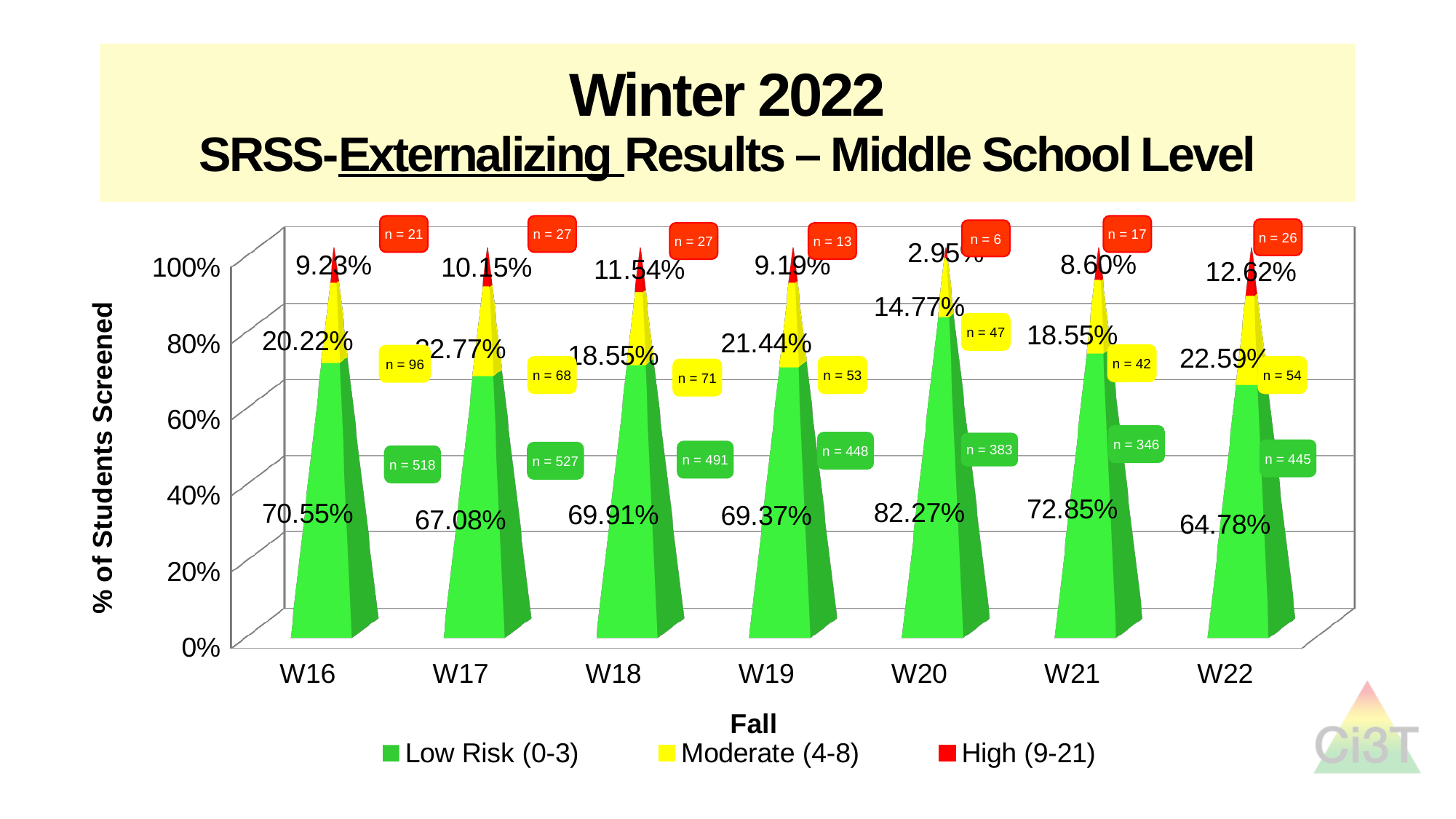
What is the Moderate (4-8) percentage for W19? 21.44% Which category has the highest Low Risk (0-3) percentage? W20 What is the difference between the Low Risk (0-3) percentages for W20 and W22? 17.49% What is the title of the x axis? Fall Which category has the lowest High (9-21) percentage? W20 Which is larger, the Moderate (4-8) percentage for W17 or for W18? W17 What is the Low Risk (0-3) percentage for W20? 82.27% How many categories are shown on the x axis? 7 What is the High (9-21) percentage for W22? 12.62% How many series does the legend list? 3 Which category has the lowest Low Risk (0-3) percentage? W22 What kind of chart is shown on the slide? Stacked bar chart